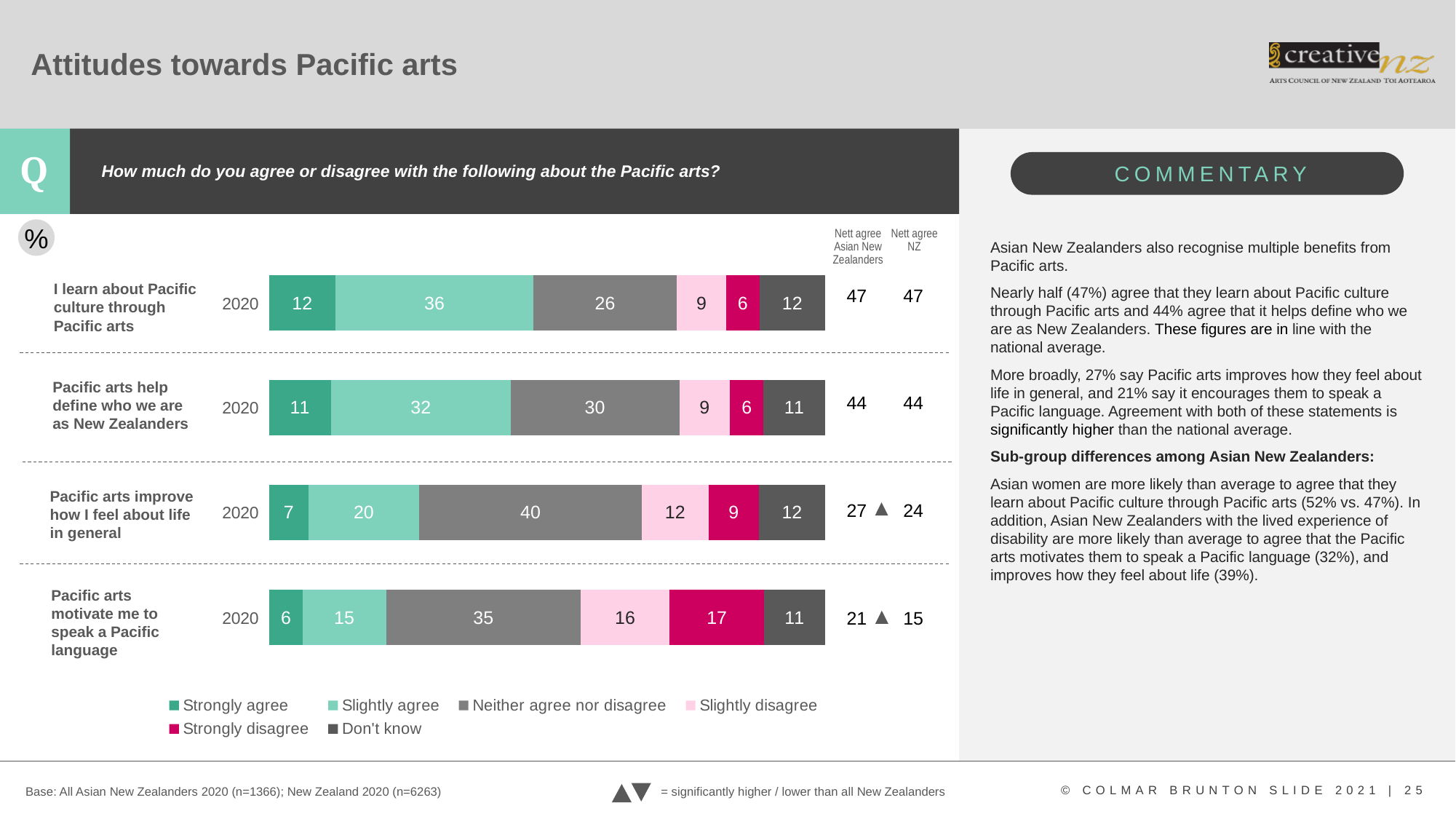
What is the difference between the Nett agree for Asian New Zealanders and the Nett agree for NZ for "Pacific arts motivate me to speak a Pacific language"? 6 What is the "Strongly disagree" value for "Pacific arts motivate me to speak a Pacific language"? 17 What is the Nett agree figure for Asian New Zealanders for "Pacific arts improve how I feel about life in general"? 27 What is the "Neither agree nor disagree" value for "Pacific arts improve how I feel about life in general"? 40 Which statement has a larger "Strongly disagree" value: "Pacific arts improve how I feel about life in general" or "Pacific arts motivate me to speak a Pacific language"? Pacific arts motivate me to speak a Pacific language What percentage strongly agree with the statement "I learn about Pacific culture through Pacific arts"? 12 What is the difference in the "Slightly agree" value between "I learn about Pacific culture through Pacific arts" and "Pacific arts help define who we are as New Zealanders"? 4 What kind of chart is shown on the slide? Stacked bar chart Which statement has the highest "Slightly agree" value? I learn about Pacific culture through Pacific arts Which statement has the lowest "Strongly agree" value? Pacific arts motivate me to speak a Pacific language How many series does the legend list? 6 How many statements are shown in the chart? 4